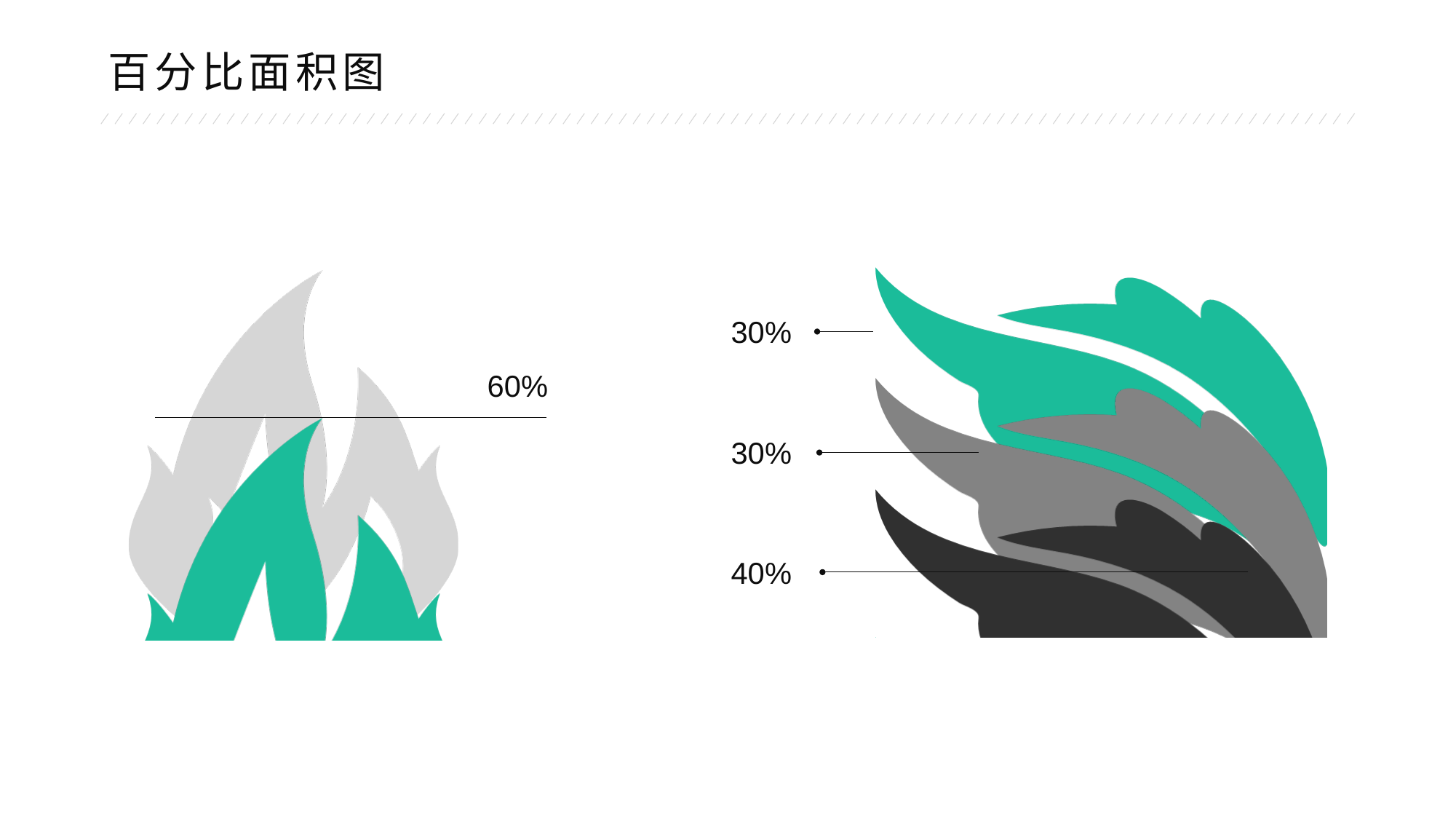
On the right chart (the layered wing shapes), what is the value labeled for the bottom black layer? 40% On the right chart (the layered wing shapes), which is larger: the black layer's value or the gray layer's value? The black layer's value (40%) On the right chart (the layered wing shapes), which layer has the highest labeled value? The bottom black layer (40%) On the right chart (the layered wing shapes), what is the value labeled for the middle gray layer? 30% On the right chart (the layered wing shapes), what is the value labeled for the top green layer? 30% On the right chart (the layered wing shapes), do the green and gray layers have the same labeled value? Yes, both are 30% What colour is the portion of the left flame chart that is labeled 60%? Green On the right chart (the layered wing shapes), how many percentage values are labeled? 3 On the left chart (the flame), what percentage is labeled? 60% What is the title of the slide? 百分比面积图 On the right chart (the layered wing shapes), what is the difference between the black layer's value and the green layer's value? 10% On the right chart (the layered wing shapes), what do the three labeled percentages add up to? 100%